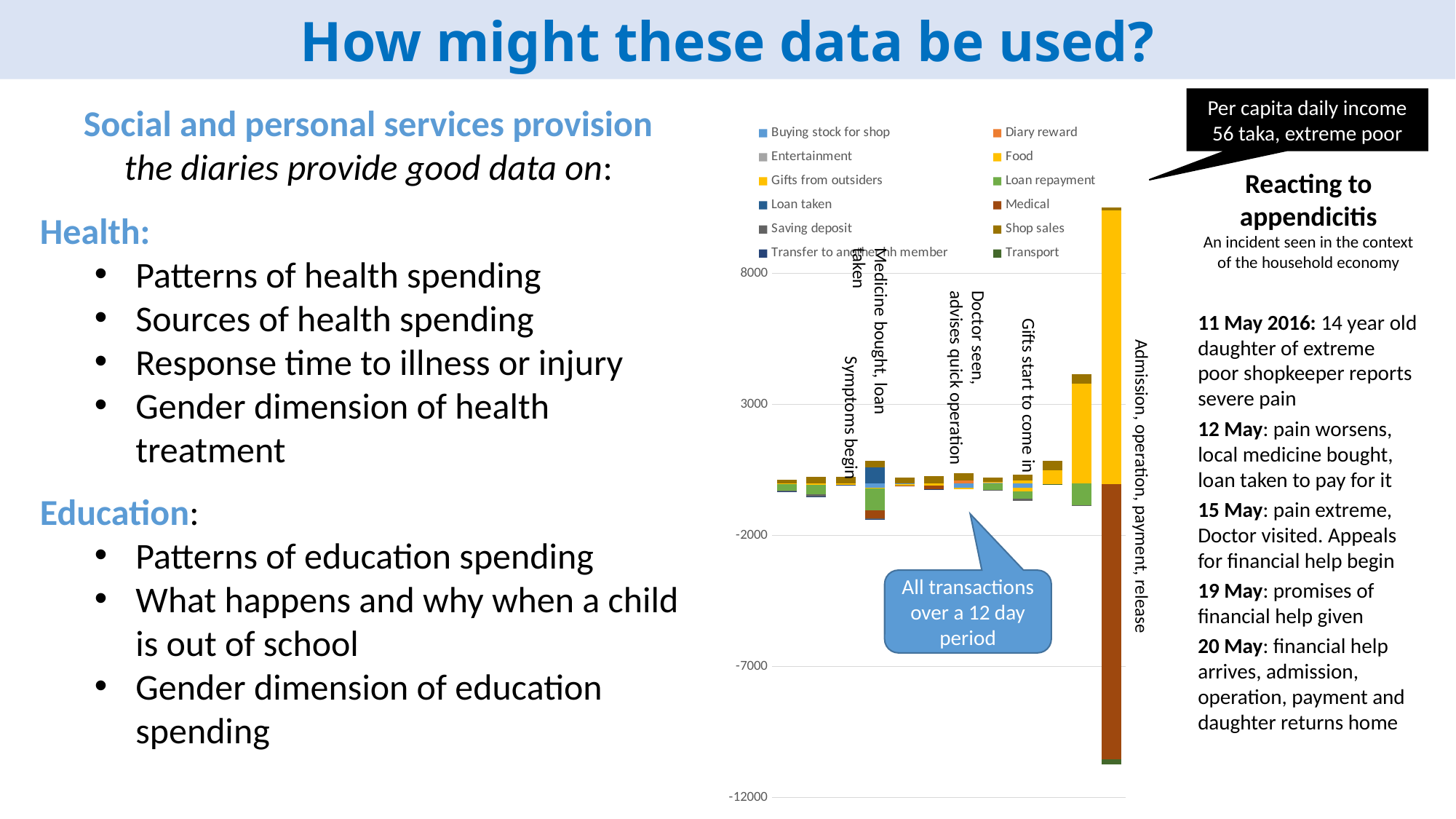
What is the lowest value shown on the chart's vertical axis? -12000 How many bars (days) are plotted in the chart? 12 Which bar in the chart reaches the highest positive value? Admission, operation, payment, release How many series does the chart's legend list? 12 Is the negative part of the 'Admission, operation, payment, release' bar greater or less than -7000? less Is the positive part of the 'Admission, operation, payment, release' bar greater or less than 8000? greater Which is taller, the 'Symptoms begin' bar or the 'Admission, operation, payment, release' bar? Admission, operation, payment, release What kind of chart is shown on the slide? Stacked bar chart Is the positive part of the bar immediately before 'Admission, operation, payment, release' greater or less than 3000? greater Which series makes up almost all of the negative part of the 'Admission, operation, payment, release' bar? Medical Which bar in the chart reaches the lowest (most negative) value? Admission, operation, payment, release According to the callout on the chart, over what period are all transactions shown? A 12 day period